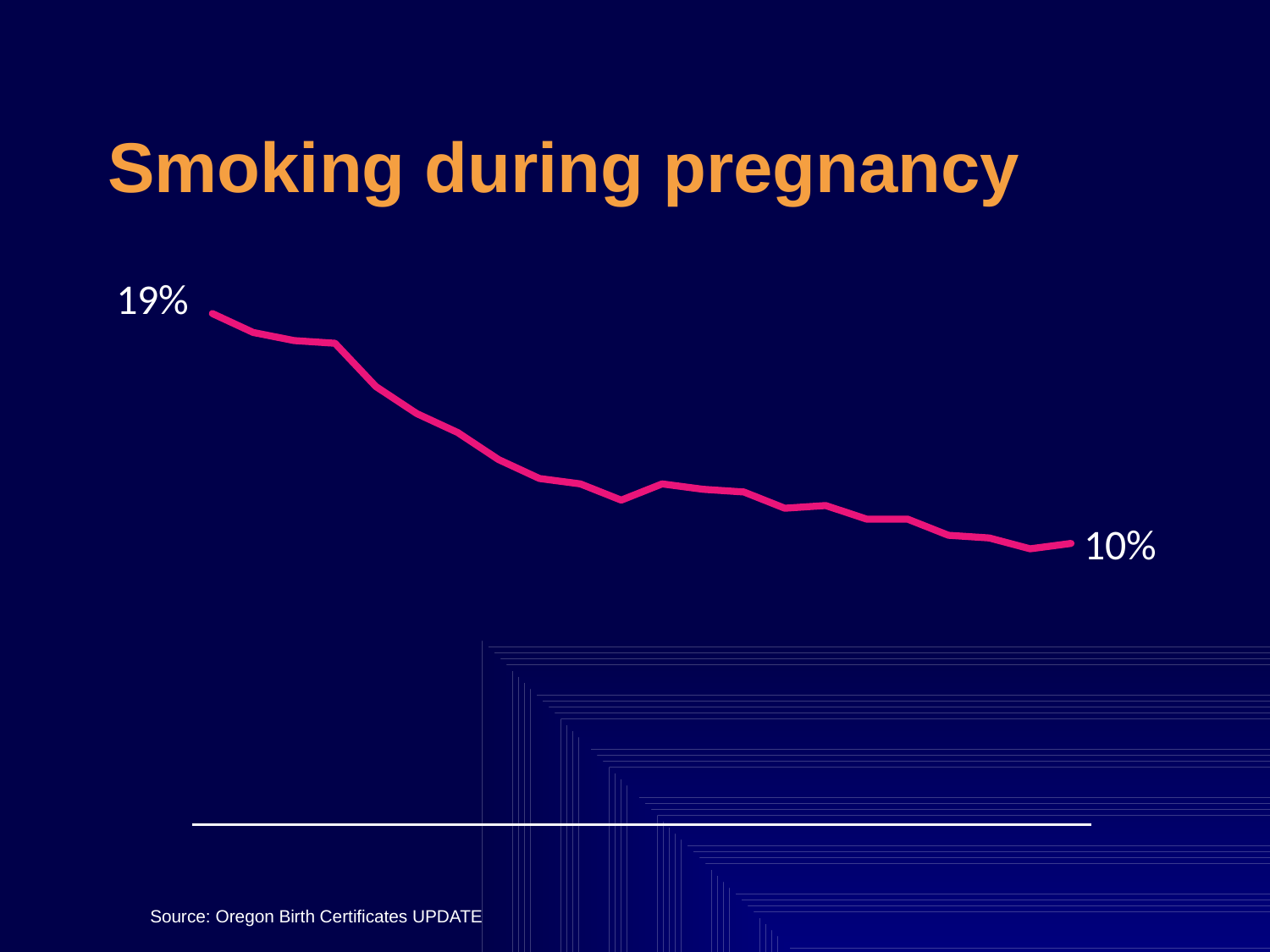
What is the value shown at the start of the line? 19% What is the title of the chart? Smoking during pregnancy What kind of chart is shown on the slide? line chart What source is cited for the chart data? Oregon Birth Certificates UPDATE What is the value shown at the end of the line? 10% Which is larger, the value at the start of the line or the value at the end? the start (19%) What is the difference between the first value (19%) and the last value (10%) on the line? 9 percentage points Do the values rise or fall along the x axis? fall